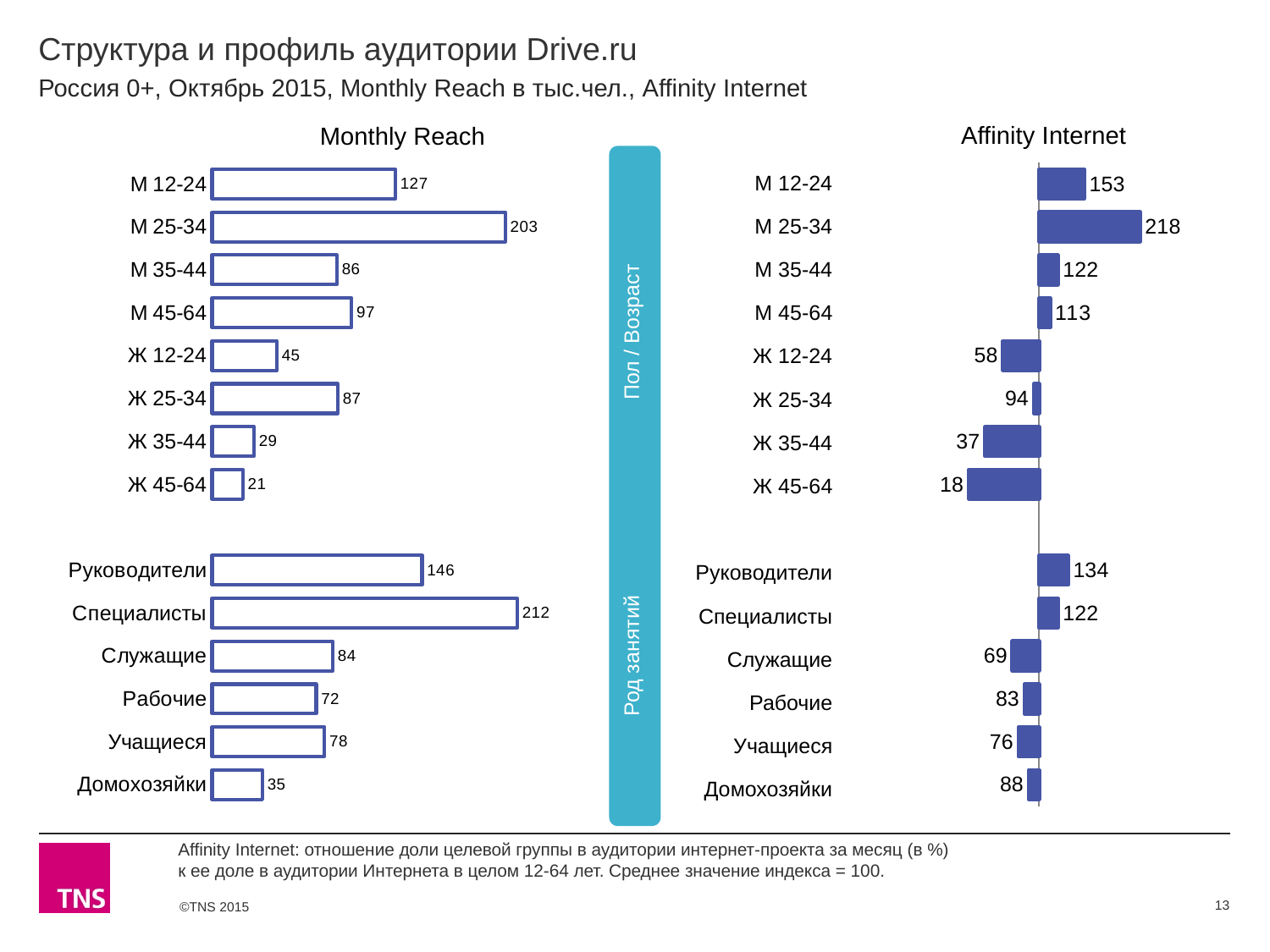
In the Monthly Reach chart, which category has the highest value? Специалисты How many categories are plotted in the Monthly Reach chart? 14 What are the two group labels shown on the vertical band between the charts? Пол / Возраст and Род занятий In the Affinity Internet chart, what is the difference between М 25-34 and М 35-44? 96 In the Affinity Internet chart, what is the value for Ж 45-64? 18 In the Monthly Reach chart, what is the difference between Руководители and Служащие? 62 In the Affinity Internet chart, what is the value for Специалисты? 122 In the Monthly Reach chart, what is the value for М 25-34? 203 What type of chart is the Affinity Internet chart? Bar chart In the Monthly Reach chart, what is the value for Домохозяйки? 35 In the Affinity Internet chart, which is larger: М 12-24 or Руководители? М 12-24 In the Affinity Internet chart, which category has the lowest value? Ж 45-64